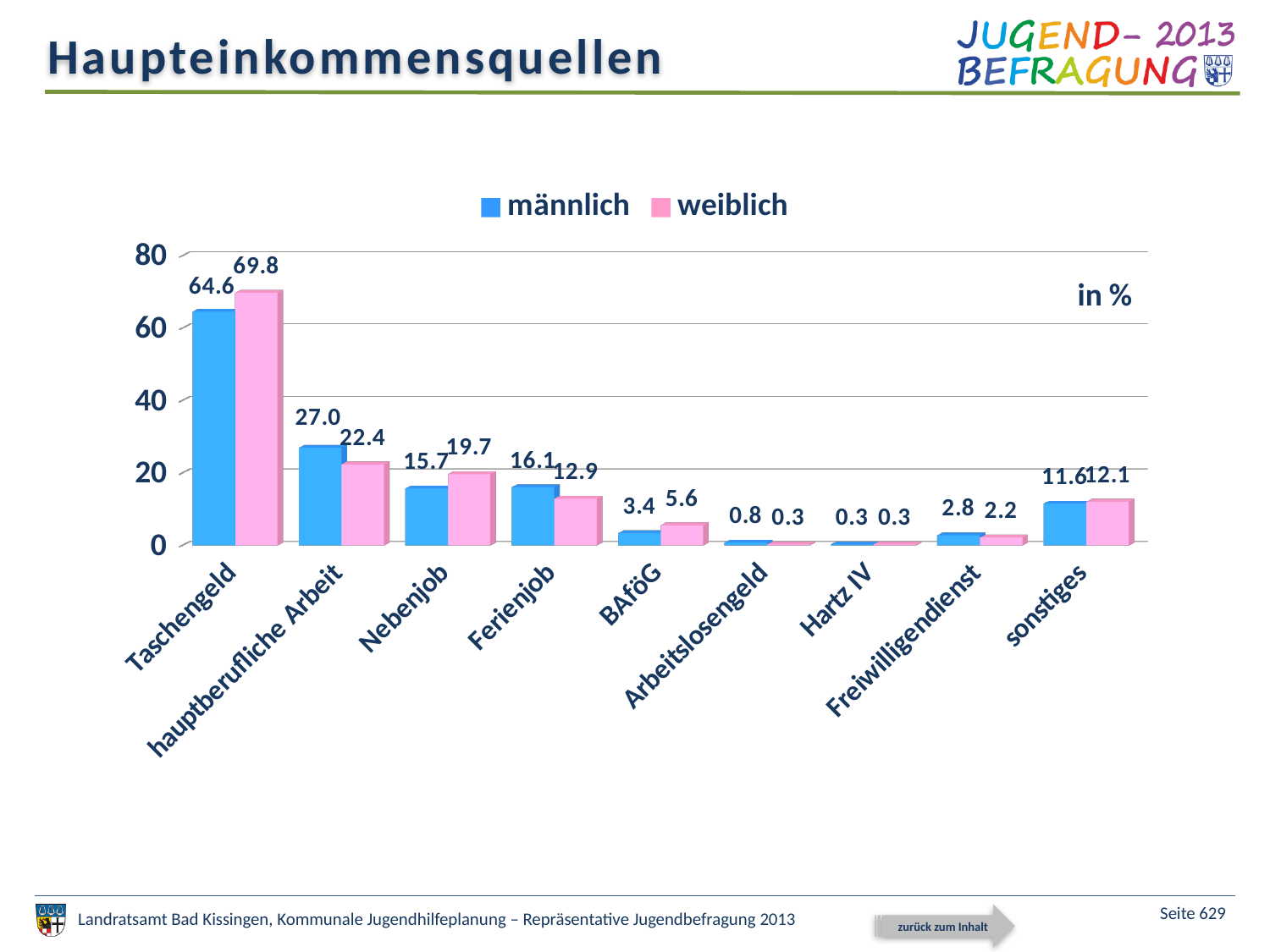
Which is larger for Ferienjob, the männlich value or the weiblich value? männlich What is the difference between the weiblich and männlich values for Taschengeld? 5.2 Which category has the highest value for weiblich? Taschengeld What is the value for männlich in the Freiwilligendienst category? 2.8 What is the value for weiblich in the Nebenjob category? 19.7 How many categories are shown on the x axis? 9 Which category has the lowest value for männlich? Hartz IV What kind of chart is shown on the slide? bar chart How many series does the legend list? 2 Is the männlich value for hauptberufliche Arbeit greater or less than 20? greater What is the value for männlich in the Taschengeld category? 64.6 What is the value for weiblich in the hauptberufliche Arbeit category? 22.4